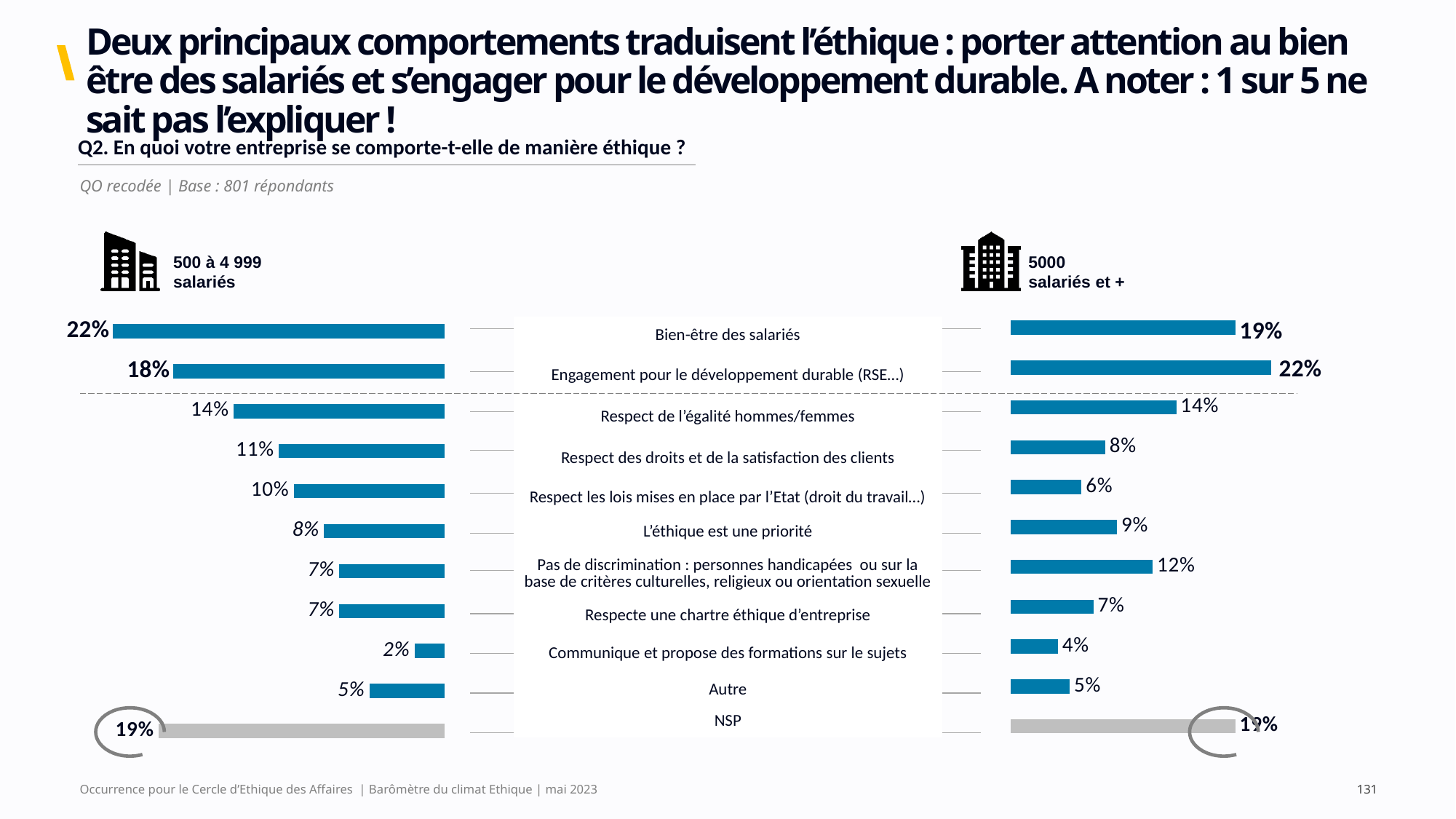
What type of chart is used on the slide? Bar chart Which is larger for 'Respect des droits et de la satisfaction des clients': the value for '500 à 4 999 salariés' or for '5000 salariés et +'? 500 à 4 999 salariés In the chart for '500 à 4 999 salariés', what is the value for 'Communique et propose des formations sur le sujets'? 2% In the chart for '500 à 4 999 salariés', what is the value for 'Bien-être des salariés'? 22% In the chart for '5000 salariés et +', what is the value for 'Engagement pour le développement durable (RSE…)'? 22% In the chart for '5000 salariés et +', which category has the highest value? Engagement pour le développement durable (RSE…) In the chart for '500 à 4 999 salariés', what is the difference between 'Bien-être des salariés' and 'Engagement pour le développement durable (RSE…)'? 4% In the chart for '500 à 4 999 salariés', what is the value for 'NSP'? 19% In the chart for '500 à 4 999 salariés', which category has the lowest value? Communique et propose des formations sur le sujets In the chart for '5000 salariés et +', what is the difference between 'Respect de l'égalité hommes/femmes' and 'Respect les lois mises en place par l'Etat (droit du travail…)'? 8% How many categories are shown in each bar chart on the slide? 11 In the chart for '5000 salariés et +', what is the value for 'Pas de discrimination : personnes handicapées ou sur la base de critères culturelles, religieux ou orientation sexuelle'? 12%